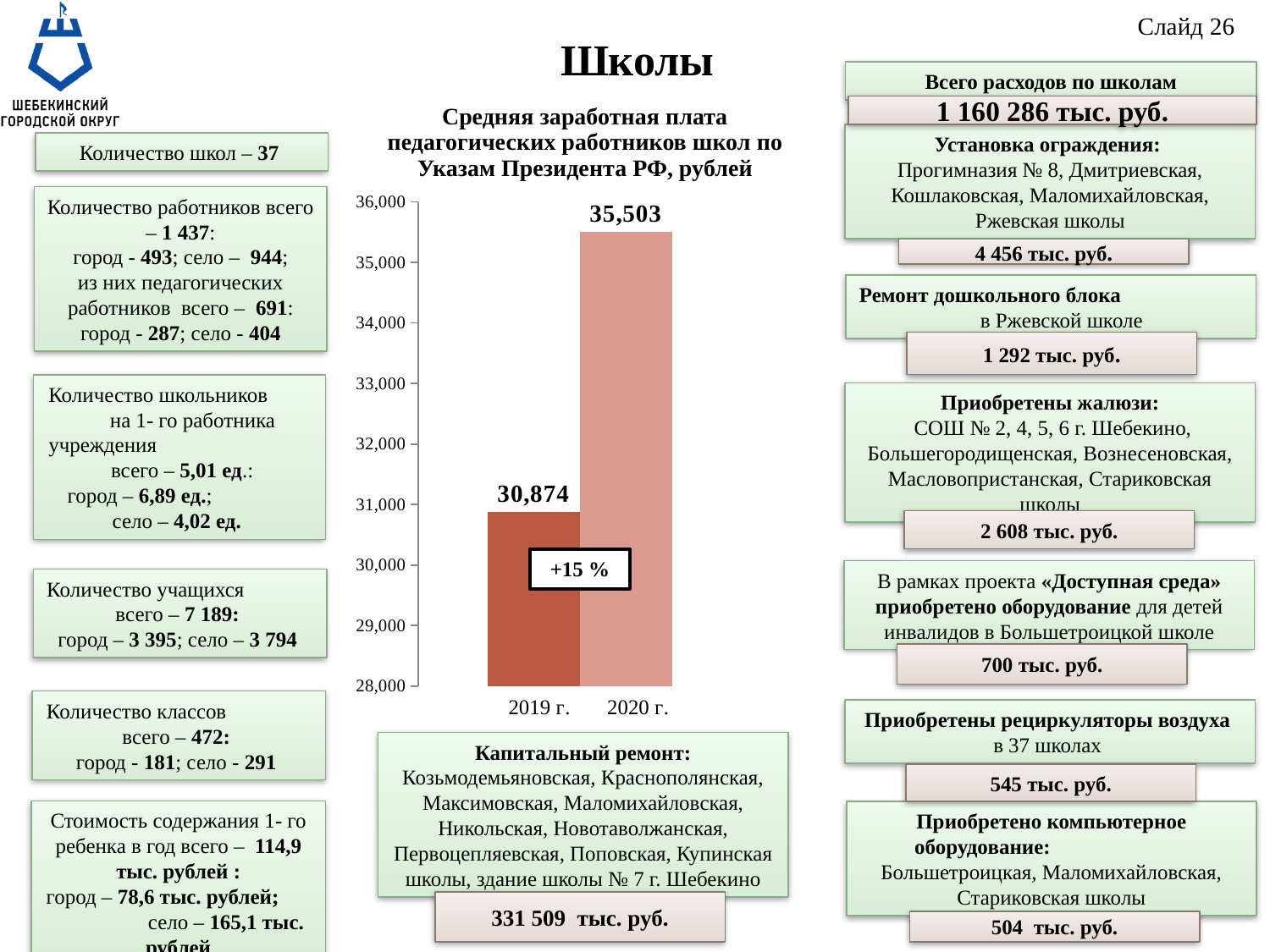
What kind of chart is shown on the slide? bar chart Do the values rise or fall from 2019 г. to 2020 г.? rise How many bars are plotted in the chart? 2 What is the title of the chart? Средняя заработная плата педагогических работников школ по Указам Президента РФ, рублей What is the difference between the 2020 г. and 2019 г. values in the chart? 4,629 Is the value for 2019 г. greater or less than 31,000? less Which year has the higher value in the chart? 2020 г. Which year has the lower value in the chart? 2019 г. What percentage change is annotated on the chart? +15 % What is the value for 2019 г. in the chart? 30,874 What is the value for 2020 г. in the chart? 35,503 Is the value for 2020 г. greater or less than 35,000? greater